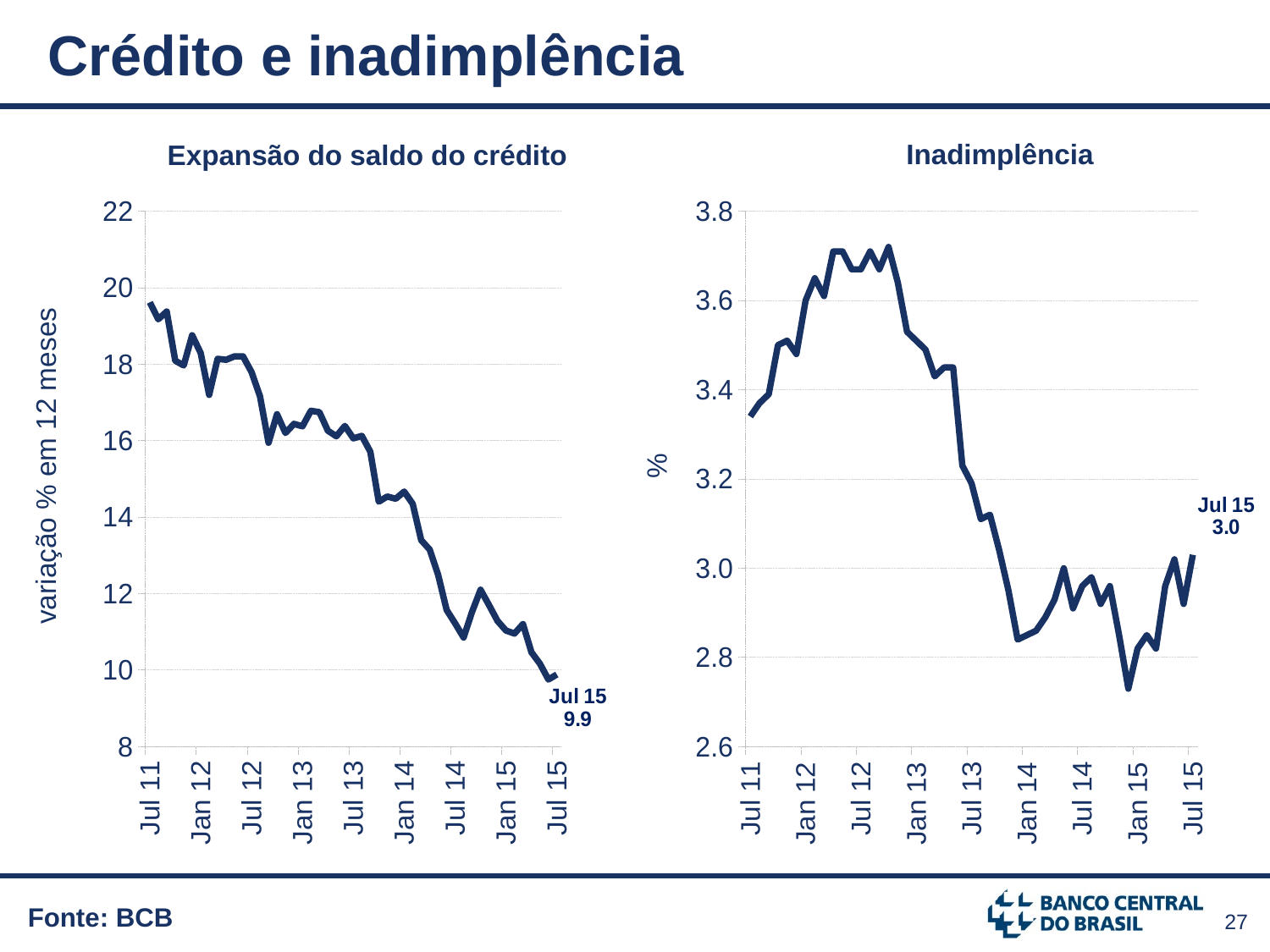
What kind of chart is the 'Inadimplência' chart? line chart On the 'Expansão do saldo do crédito' chart, what is the value labelled for Jul 15? 9.9 On the 'Inadimplência' chart, is the value for Jul 12 greater or less than 3.6? greater On the 'Expansão do saldo do crédito' chart, is the value for Jul 11 greater or less than 18? greater On the 'Inadimplência' chart, is the value for Jan 14 greater or less than 3.0? less What kind of chart is the 'Expansão do saldo do crédito' chart? line chart On the 'Expansão do saldo do crédito' chart, do the values generally rise or fall from Jul 11 to Jul 15? fall What is the title of the chart on the right side of the slide? Inadimplência What is the y-axis title of the 'Expansão do saldo do crédito' chart? variação % em 12 meses On the 'Inadimplência' chart, what is the value labelled for Jul 15? 3.0